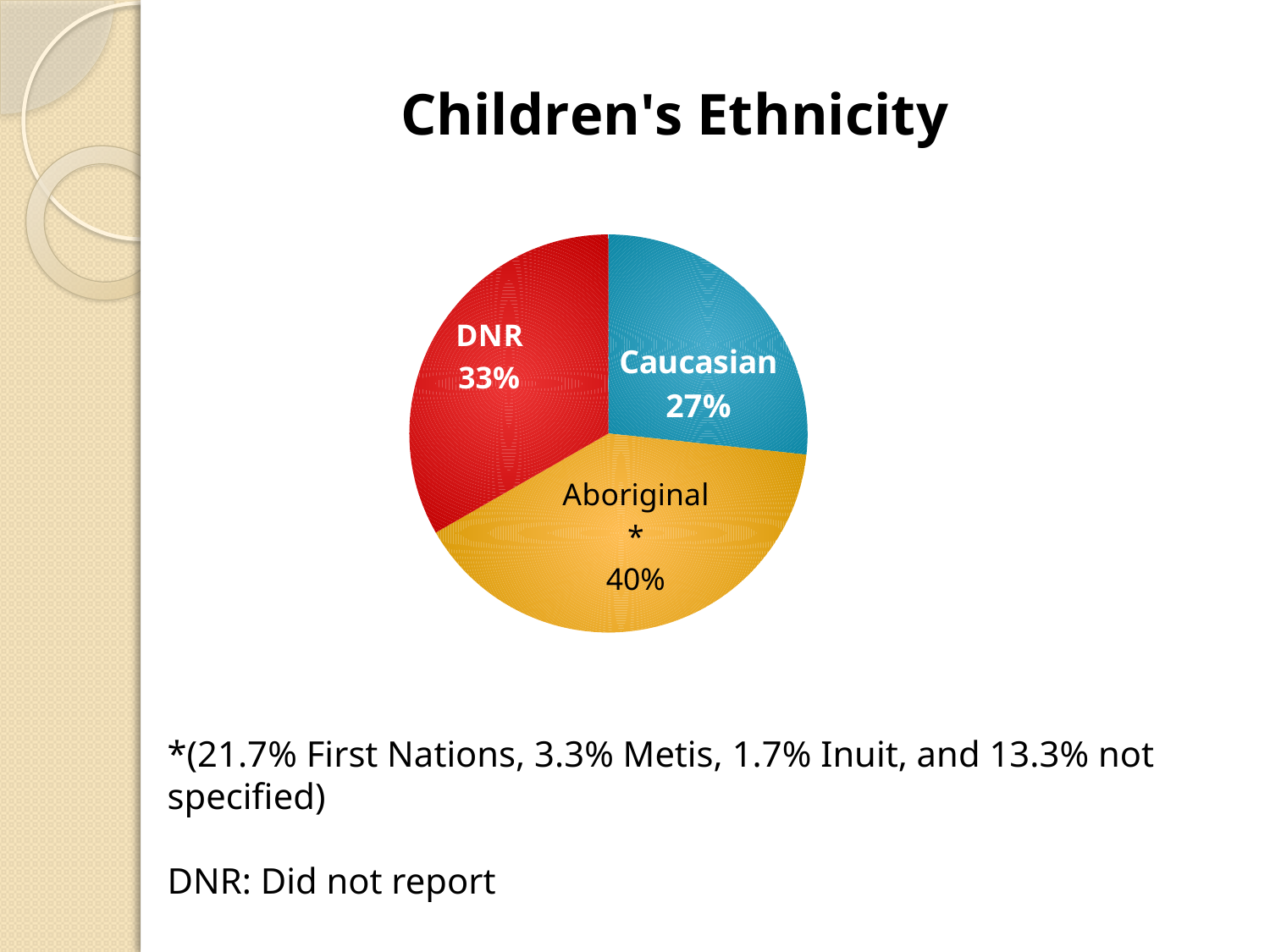
Which category has the largest share of the pie chart? Aboriginal What type of chart is shown on the slide? Pie chart What colour is the Aboriginal slice of the pie chart? Yellow/orange Which category has the smallest share of the pie chart? Caucasian Which slice is larger, DNR or Caucasian? DNR What is the difference in percentage points between the DNR and Caucasian slices? 6 What percentage of children are Caucasian according to the pie chart? 27% What is the title of the chart? Children's Ethnicity What is the difference in percentage points between the Aboriginal and Caucasian slices? 13 What percentage of children are Aboriginal according to the pie chart? 40% What percentage is shown for the DNR slice of the pie chart? 33% How many slices does the pie chart have? 3